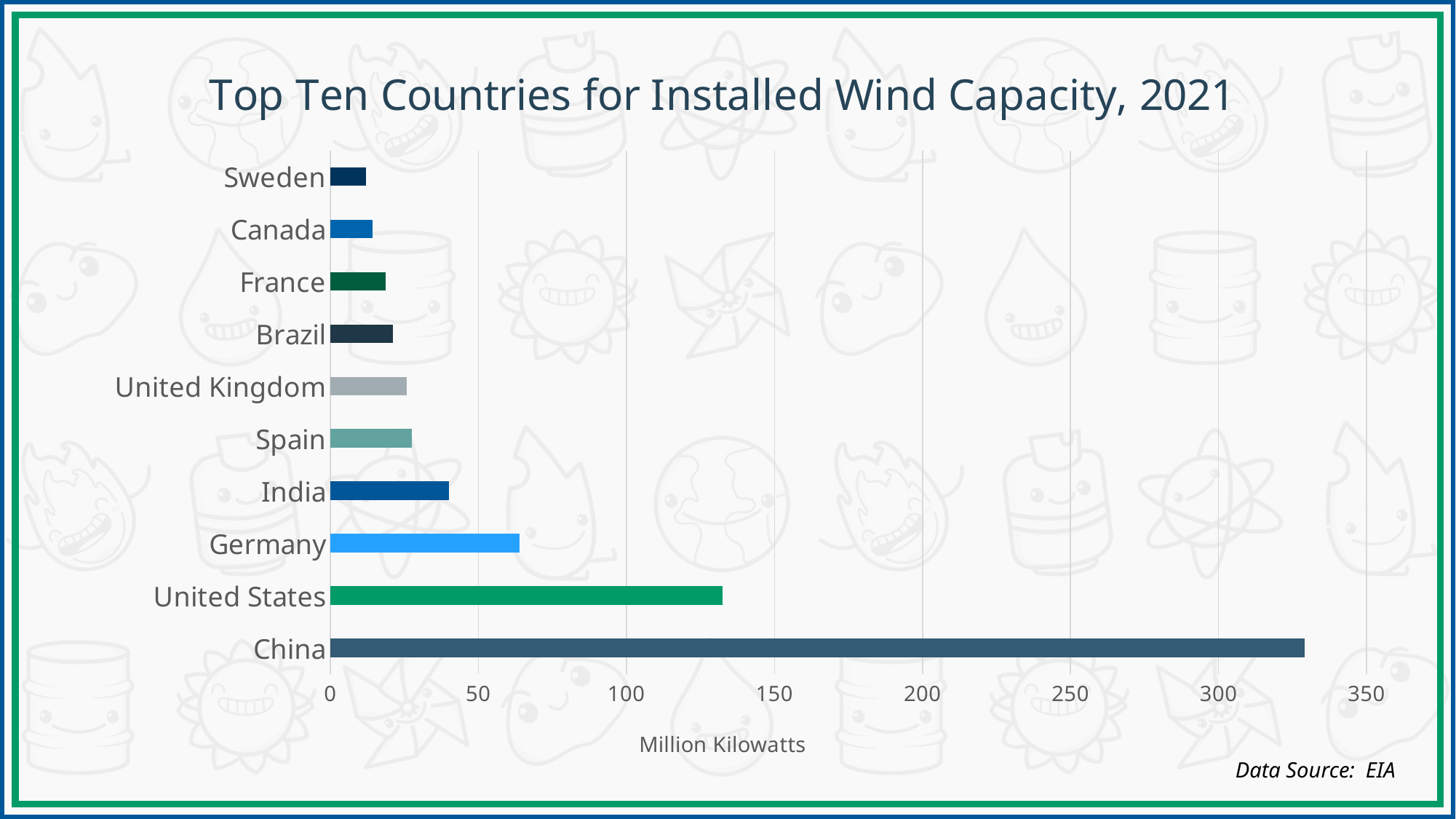
What is the title of the chart? Top Ten Countries for Installed Wind Capacity, 2021 Is the value for China greater or less than 300? greater What kind of chart is shown on the slide? Bar chart Is the value for India greater or less than 50? less Which has the larger installed wind capacity, Germany or India? Germany Which has the larger installed wind capacity, China or the United States? China What unit is shown on the horizontal axis of the chart? Million Kilowatts How many countries are shown in the chart? 10 Is the value for the United States greater or less than 100? greater Which country has the highest installed wind capacity in the chart? China